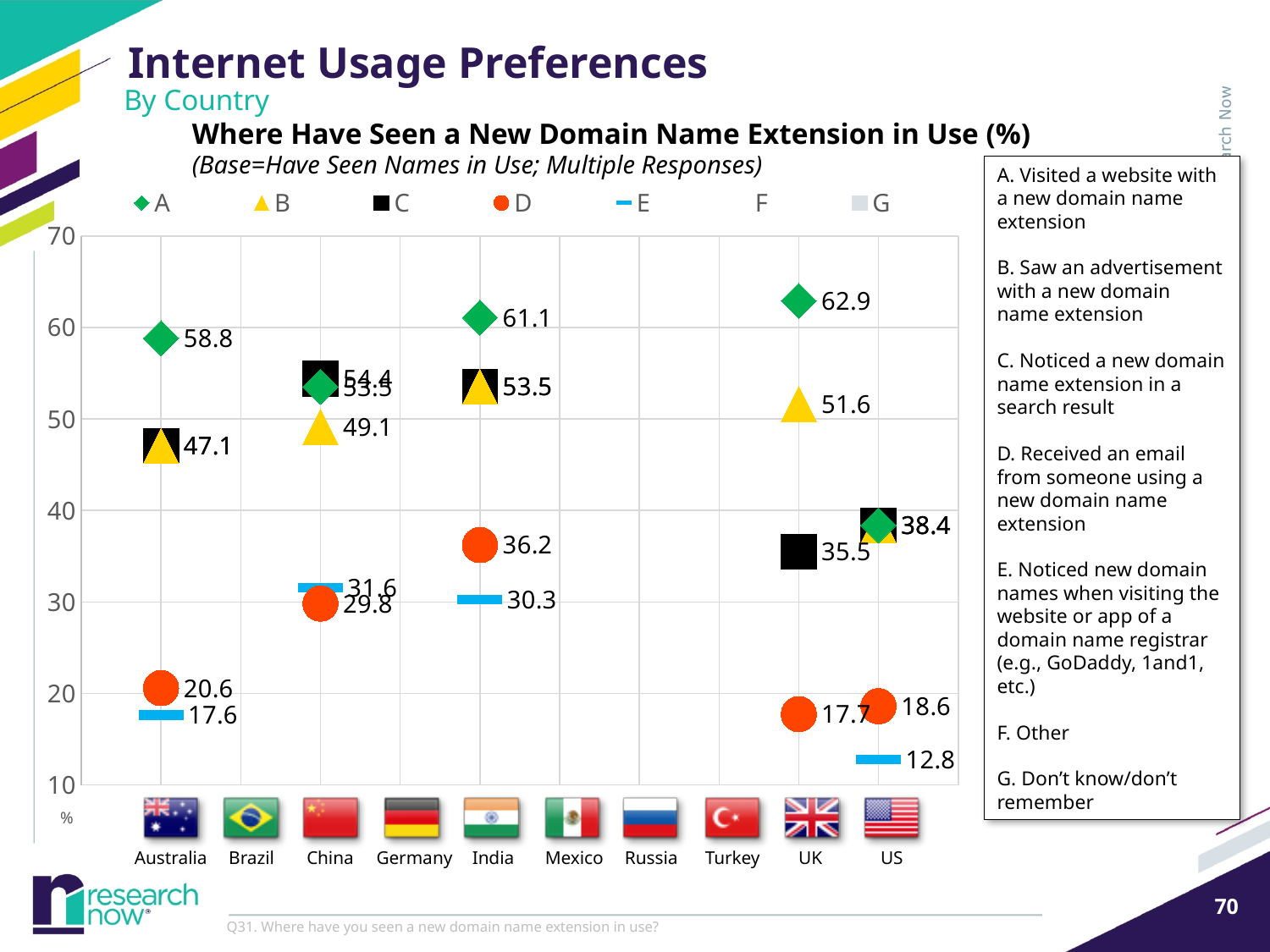
Which country has the highest value for series A? UK What is the value for series A for the UK? 62.9 How many countries are shown along the x axis? 10 Which country has the lowest value for series D? UK What is the difference between the series A values for the UK and Australia? 4.1 What is the value for series D (received an email) for India? 36.2 Which country has the larger series A value, India or China? India What is the value for series A (visited a website with a new domain name extension) for Australia? 58.8 How many series does the legend list? 7 What is the value for series B (saw an advertisement) for the UK? 51.6 What is the value for series E for the US? 12.8 What is the difference between the series D and series E values for India? 5.9